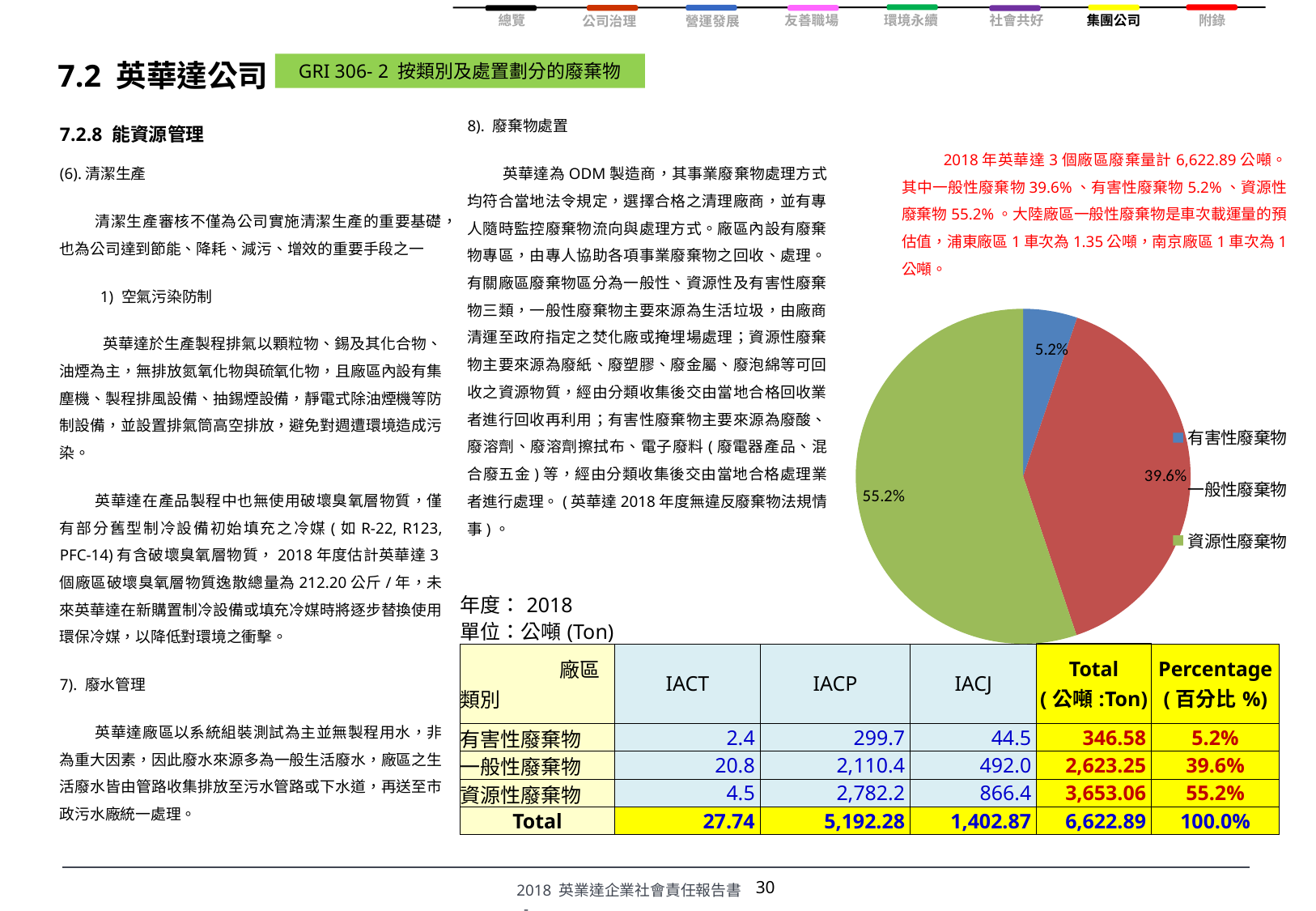
What share of the pie does 資源性廢棄物 represent? 55.2% How many entries does the legend of the pie chart list? 3 What is the difference in percentage points between the 資源性廢棄物 slice and the 一般性廢棄物 slice? 15.6% What share of the pie does 有害性廢棄物 represent? 5.2% Which category has the smallest slice of the pie? 有害性廢棄物 What is the difference in percentage points between the 一般性廢棄物 slice and the 有害性廢棄物 slice? 34.4% What kind of chart is shown on the slide? pie chart Which slice is larger, 一般性廢棄物 or 有害性廢棄物? 一般性廢棄物 Which category has the largest slice of the pie? 資源性廢棄物 What colour is the 有害性廢棄物 slice in the pie chart? blue How many slices does the pie chart have? 3 What share of the pie does 一般性廢棄物 represent? 39.6%